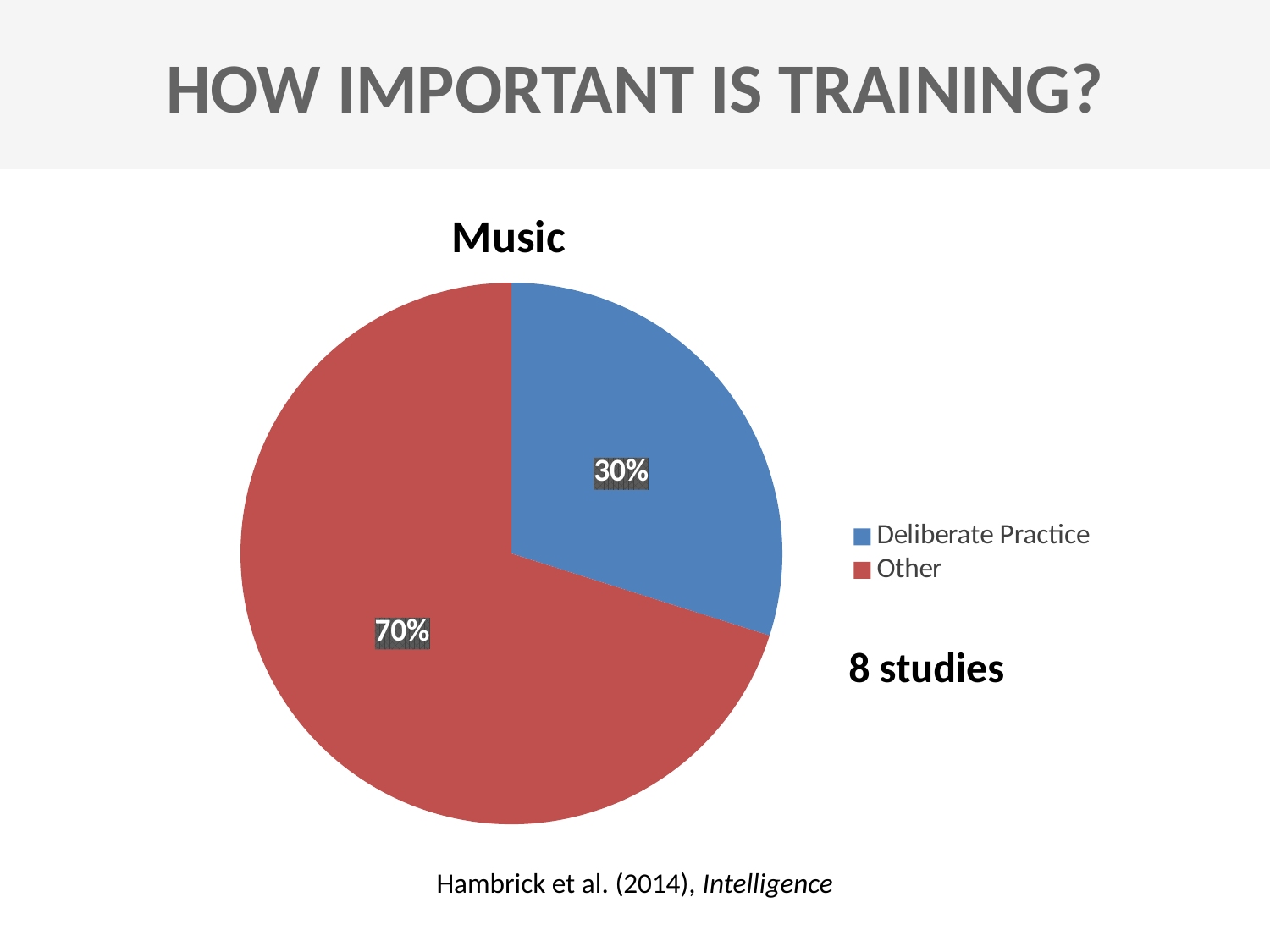
What kind of chart is shown on the slide? pie chart Which is larger, the Deliberate Practice slice or the Other slice? Other Is the value for Deliberate Practice greater or less than 50%? less What is the difference in percentage points between the Other slice and the Deliberate Practice slice? 40 How many slices does the pie chart have? 2 Which slice is the smallest? Deliberate Practice What colour is the Deliberate Practice slice? blue How many entries does the legend list? 2 What share of the pie does Deliberate Practice account for? 30% What share of the pie does Other account for? 70% Which slice is the largest? Other What is the title of the chart? Music